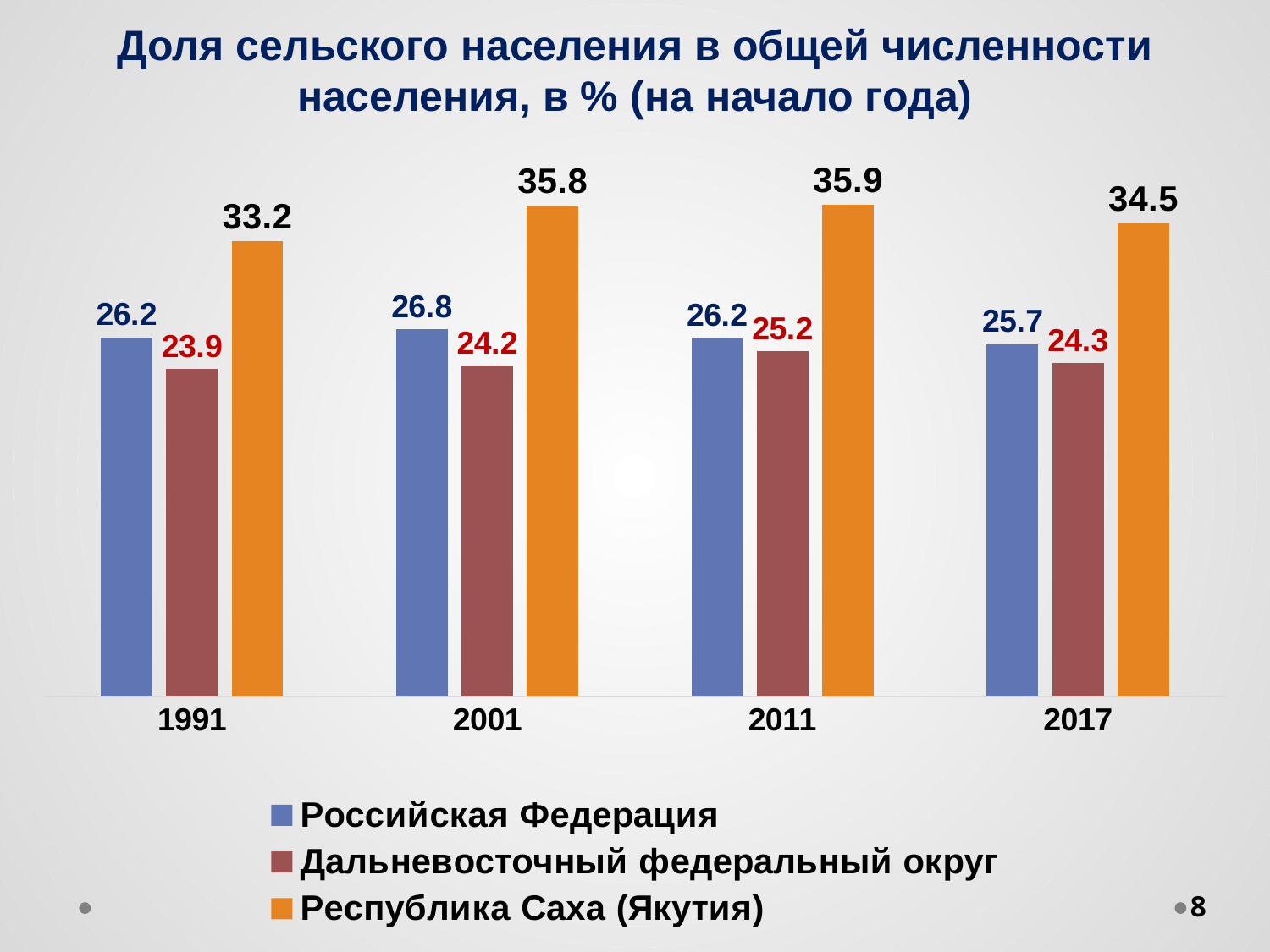
What is the value for Дальневосточный федеральный округ in 2017? 24.3 How many series does the legend list? 3 What is the value for Российская Федерация in 1991? 26.2 Which colour represents Республика Саха (Якутия) in the chart? Orange Does the value for Российская Федерация rise or fall from 2001 to 2017? Fall How many years are shown on the x axis? 4 What kind of chart is shown on the slide? Bar chart Which is larger in 2017: the value for Российская Федерация or the value for Дальневосточный федеральный округ? Российская Федерация What is the difference between the Республика Саха (Якутия) value and the Российская Федерация value in 2001? 9.0 In which year is the value for Дальневосточный федеральный округ the lowest? 1991 What is the value for Республика Саха (Якутия) in 2011? 35.9 In which year is the value for Республика Саха (Якутия) the highest? 2011